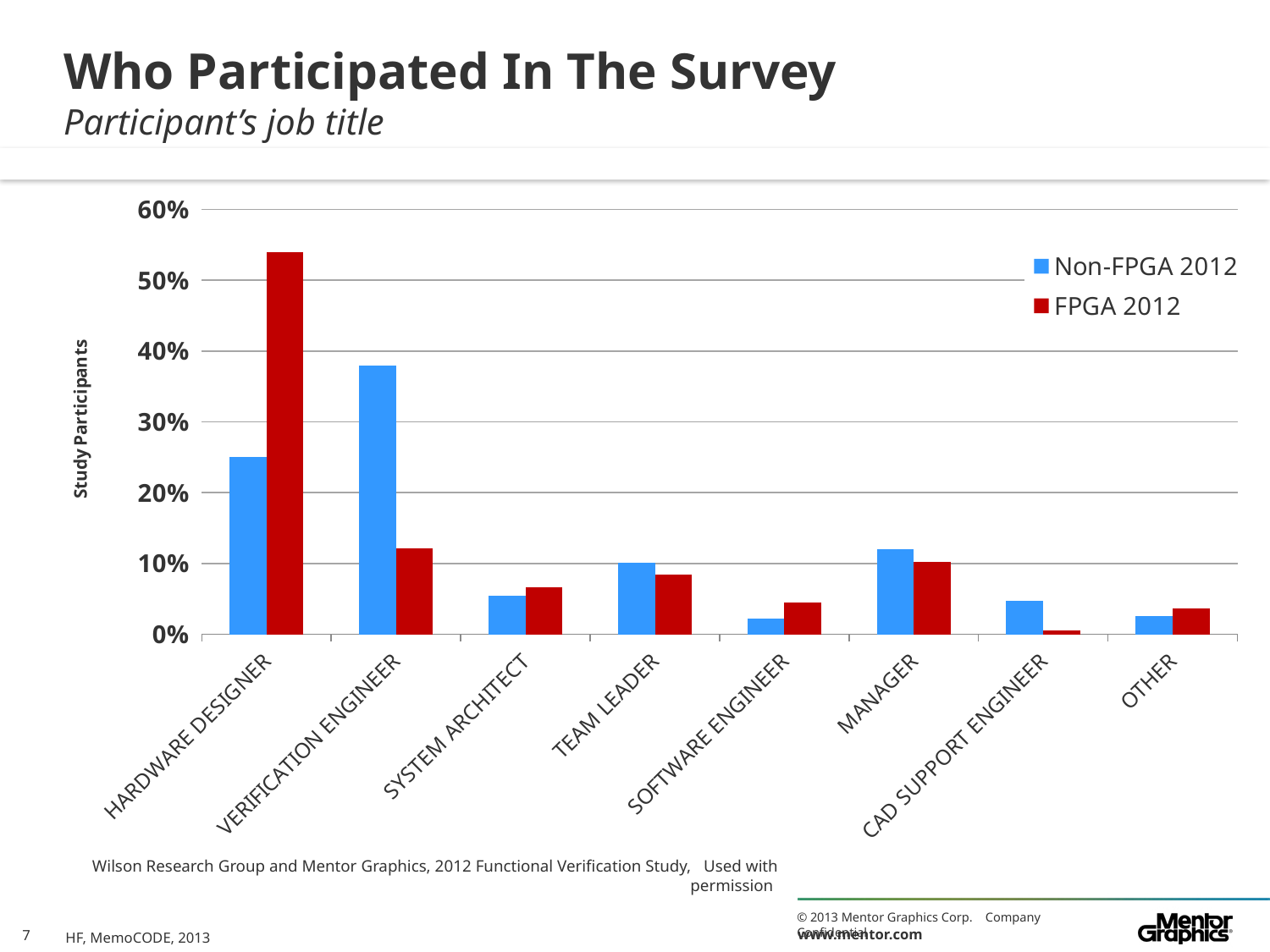
Is the Non-FPGA 2012 value for Verification Engineer greater or less than 30%? greater For Verification Engineer, which series has the larger value, Non-FPGA 2012 or FPGA 2012? Non-FPGA 2012 Is the Non-FPGA 2012 value for Hardware Designer greater or less than 20%? greater Is the FPGA 2012 value for Hardware Designer greater or less than 50%? greater Which job title has the highest value for the Non-FPGA 2012 series? Verification Engineer How many job title categories are shown on the x axis? 8 What kind of chart is shown on the slide? bar chart How many series does the legend list? 2 For Hardware Designer, which series has the larger value, Non-FPGA 2012 or FPGA 2012? FPGA 2012 What is the label on the vertical axis of the chart? Study Participants Which job title has the highest value for the FPGA 2012 series? Hardware Designer Which job title has the lowest value for the FPGA 2012 series? CAD Support Engineer